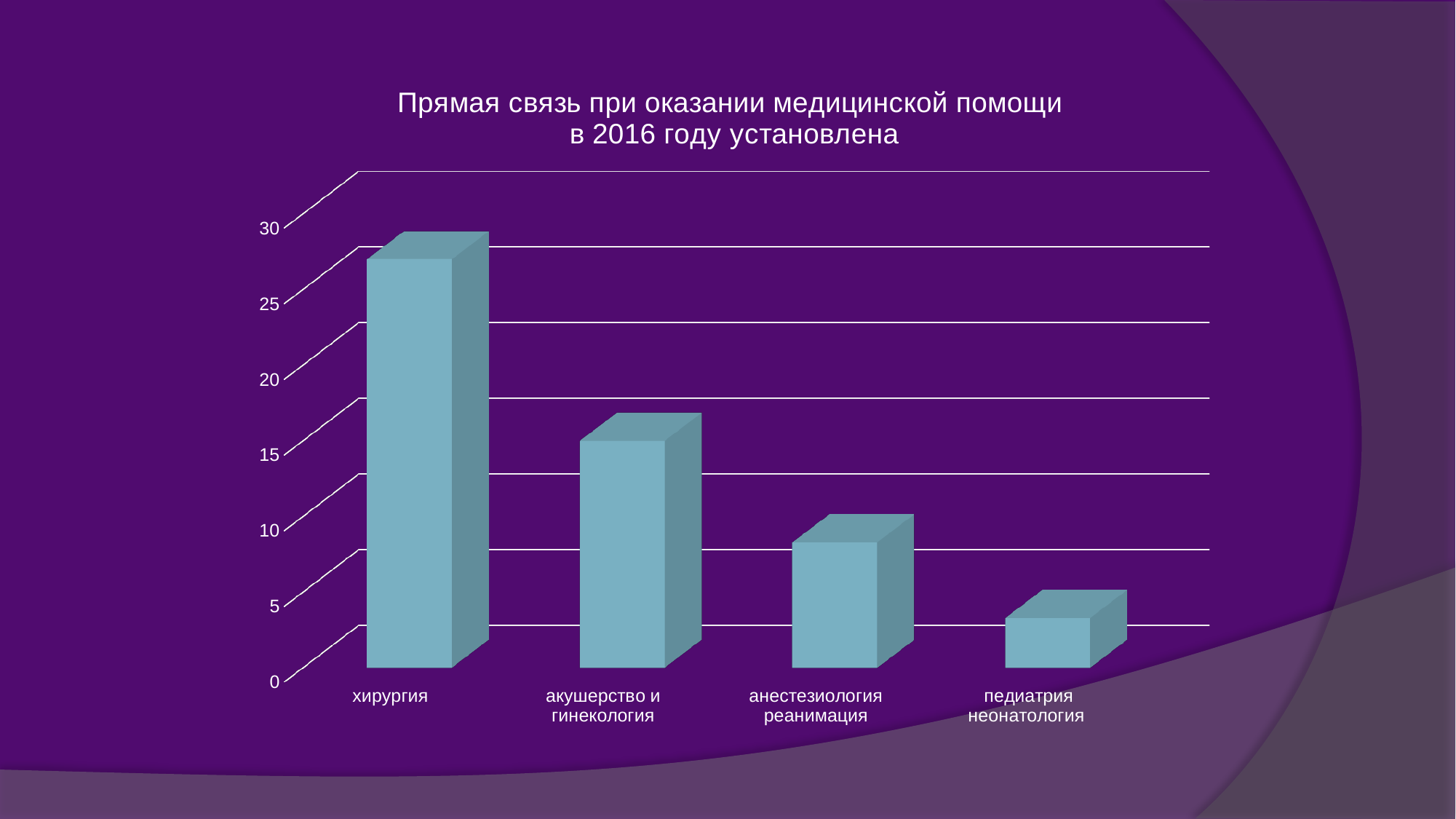
Is the value for хирургия greater or less than 20? greater Which is larger, the value for акушерство и гинекология or the value for анестезиология реанимация? акушерство и гинекология How many categories are shown on the x axis of the chart? 4 Which category has the highest bar? хирургия Is the value for педиатрия неонатология greater or less than 5? less Which category has the lowest bar? педиатрия неонатология What is the title of the chart? Прямая связь при оказании медицинской помощи в 2016 году установлена What kind of chart is shown on the slide? bar chart Which is larger, the value for хирургия or the value for педиатрия неонатология? хирургия Do the bar values rise or fall from left to right along the x axis? fall Is the value for анестезиология реанимация greater or less than 10? less